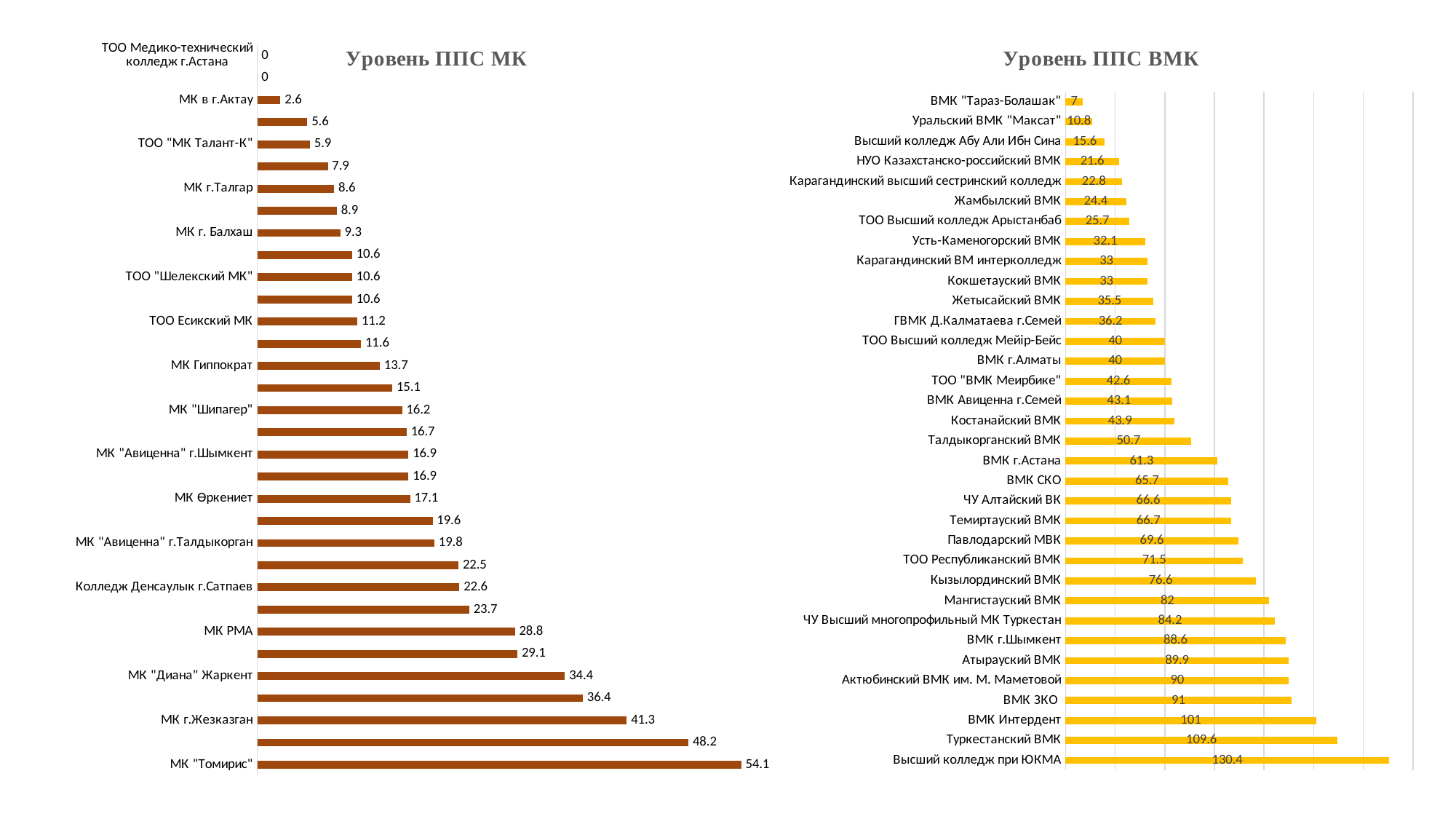
In the chart titled "Уровень ППС ВМК", what is the difference between Высший колледж при ЮКМА and Туркестанский ВМК? 20.8 In the chart titled "Уровень ППС ВМК", which category has the lowest value? ВМК "Тараз-Болашак" In the chart titled "Уровень ППС ВМК", which category has the highest value? Высший колледж при ЮКМА In the chart titled "Уровень ППС МК", which is larger: МК РМА or МК Гиппократ? МК РМА In the chart titled "Уровень ППС ВМК", what is the value for Талдыкорганский ВМК? 50.7 In the chart titled "Уровень ППС МК", what is the difference between МК "Томирис" and МК г.Жезказган? 12.8 In the chart titled "Уровень ППС ВМК", which is larger: ВМК г.Астана or ВМК г.Алматы? ВМК г.Астана In the chart titled "Уровень ППС МК", what is the value for МК "Томирис"? 54.1 In the chart titled "Уровень ППС ВМК", what is the value for Высший колледж при ЮКМА? 130.4 What type of chart is the chart titled "Уровень ППС ВМК"? Bar chart In the chart titled "Уровень ППС МК", what is the value for МК РМА? 28.8 In the chart titled "Уровень ППС МК", which category has the highest value? МК "Томирис"